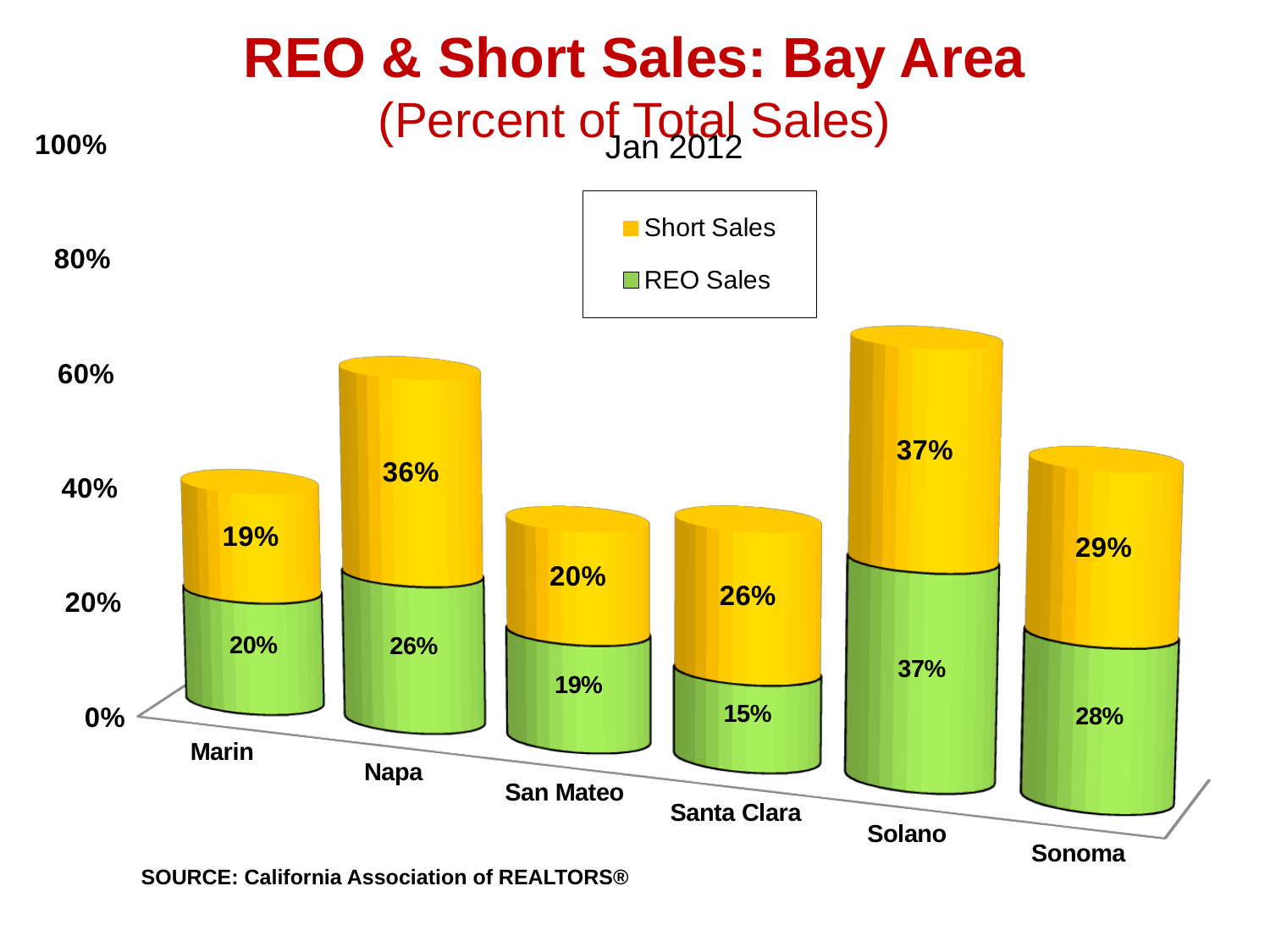
What is the combined total of Short Sales and REO Sales for Solano? 74% What is the combined total of Short Sales and REO Sales for Napa? 62% What is the REO Sales value for Santa Clara? 15% What is the difference between the Short Sales values for Solano and Marin? 18% Which is larger, the REO Sales value for Napa or the REO Sales value for San Mateo? Napa What is the REO Sales value for Sonoma? 28% How many series does the legend list? 2 How many counties are shown on the x axis? 6 What is the Short Sales value for Napa? 36% What kind of chart is shown on the slide? Stacked bar chart Which county has the lowest REO Sales value? Santa Clara Which county has the highest Short Sales value? Solano